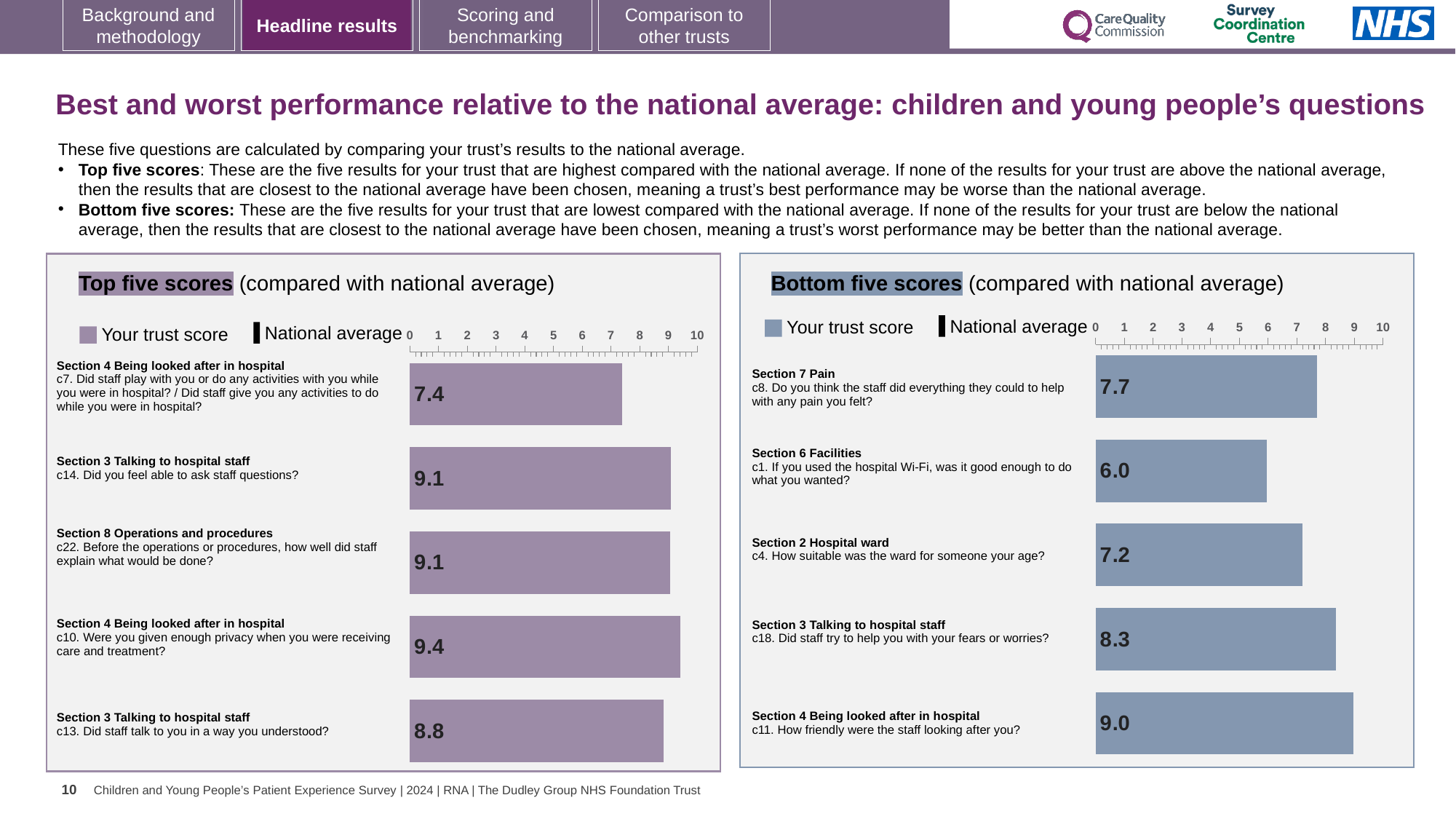
In the Top five scores chart, what is the trust score for c10 'Were you given enough privacy when you were receiving care and treatment?' 9.4 How many bars are plotted in the Bottom five scores chart? 5 In the Bottom five scores chart, which question has the lowest trust score? c1. If you used the hospital Wi-Fi, was it good enough to do what you wanted? In the Bottom five scores chart, what is the difference between the trust scores for c11 (friendly staff) and c1 (hospital Wi-Fi)? 3.0 What type of chart is the Top five scores chart? Bar chart In the Bottom five scores chart, what is the trust score for c1 about the hospital Wi-Fi? 6.0 In the Top five scores chart, which question has the highest trust score? c10. Were you given enough privacy when you were receiving care and treatment? In the Top five scores chart, what is the trust score for c14 'Did you feel able to ask staff questions?' 9.1 In the Bottom five scores chart, what is the trust score for c11 'How friendly were the staff looking after you?' 9.0 In the Top five scores chart, which question has the lowest trust score? c7. Did staff play with you or do any activities with you while you were in hospital? In the Top five scores chart, what is the difference between the trust scores for c10 (privacy) and c13 (staff talking in a way you understood)? 0.6 In the Bottom five scores chart, which has the larger trust score: c8 about pain or c4 about ward suitability? c8 about pain